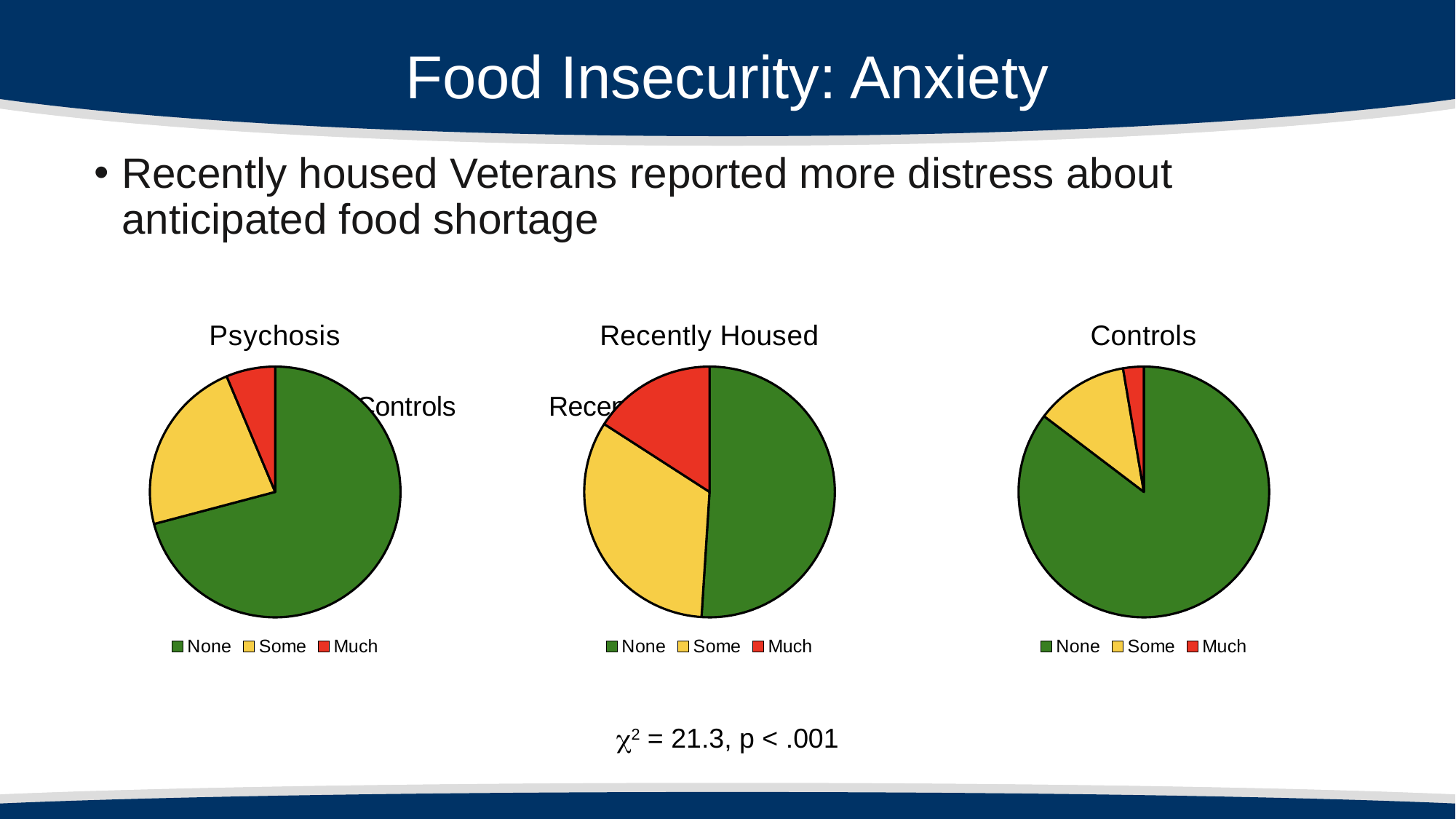
What kind of chart is the "Psychosis" chart? pie chart In the "Recently Housed" chart, which slice is larger, "Some" or "Much"? Some In the "Psychosis" chart, which category has the smallest slice? Much In the "Controls" chart, which slice is larger, "None" or "Some"? None What colour represents the "Much" category in the pie charts? red In the "Controls" chart, which category has the smallest slice? Much What are the titles of the three pie charts on the slide, from left to right? Psychosis, Recently Housed, Controls How many slices does the "Recently Housed" pie chart have? 3 In the "Psychosis" chart, which category has the largest slice? None In the "Recently Housed" chart, which category has the smallest slice? Much How many entries does the legend of the "Controls" chart list? 3 In the "Recently Housed" chart, which category has the largest slice? None